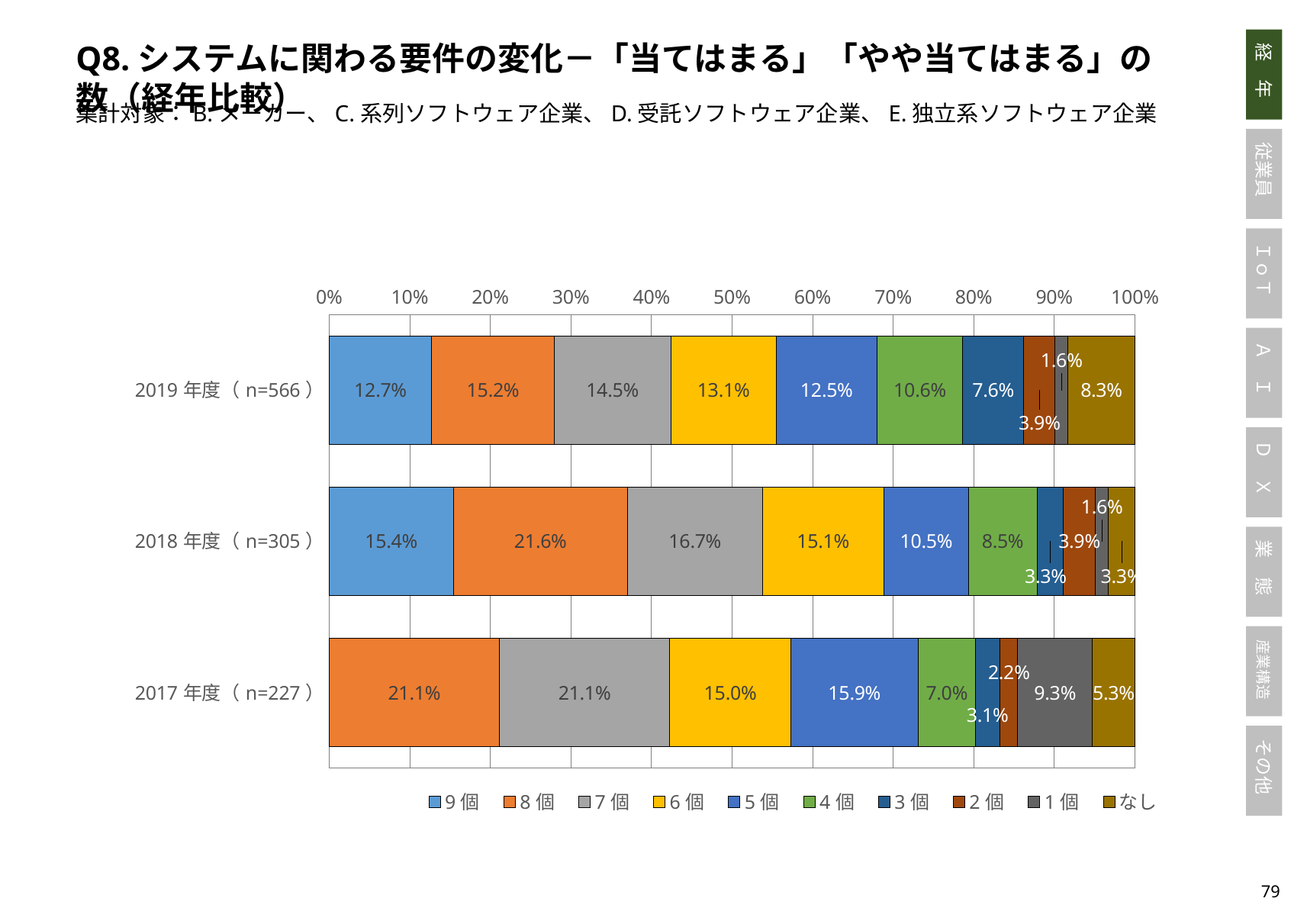
How many year categories are shown on the chart? 3 How many series does the legend list? 10 Which series has the smallest share in the 2019年度 (n=566) bar? 1個 What is the difference between the 8個 values for 2018年度 and 2019年度? 6.4% Which is larger: the 5個 value in 2017年度 or the 5個 value in 2018年度? 2017年度 What is the value for 8個 in 2018年度 (n=305)? 21.6% What is the sample size (n) for 2017年度? 227 What percentage of respondents in 2019年度 (n=566) selected 9個? 12.7% What is the value for なし in 2019年度 (n=566)? 8.3% What kind of chart is shown on the slide? Stacked bar chart What is the value for 1個 in 2017年度 (n=227)? 9.3% Which series has the largest share in the 2018年度 (n=305) bar? 8個